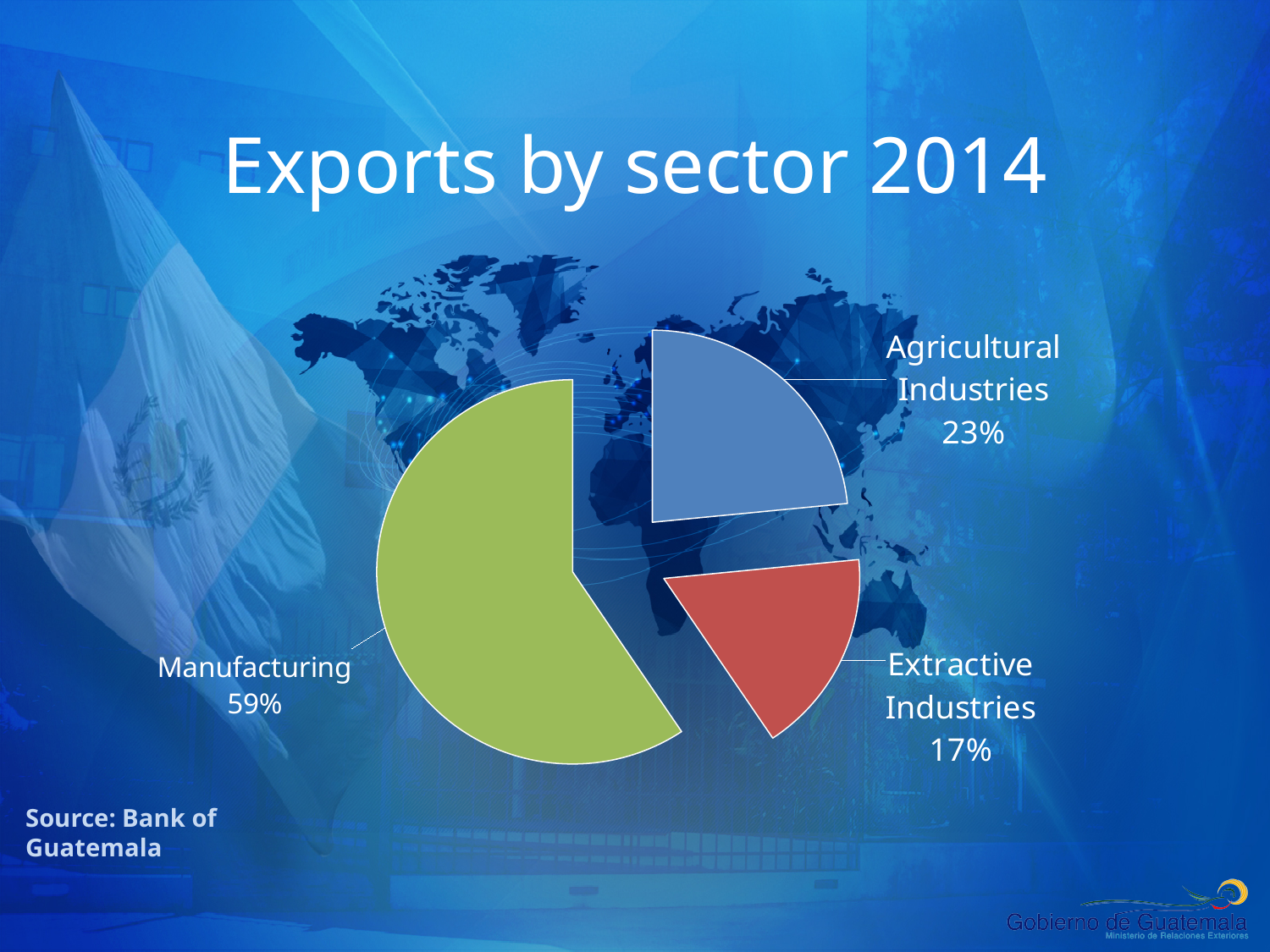
What colour is the Manufacturing slice? Green Which sector has the smallest share of exports? Extractive Industries What is the difference in percentage points between Agricultural Industries and Extractive Industries? 6 Which sector has the largest share of exports? Manufacturing What kind of chart is shown on the slide? Pie chart What is the title of the chart? Exports by sector 2014 Which has a larger share of exports, Agricultural Industries or Extractive Industries? Agricultural Industries What is the difference in percentage points between Manufacturing and Agricultural Industries? 36 What share of exports does Agricultural Industries account for? 23% What share of exports does Manufacturing account for? 59% How many sectors are shown in the pie chart? 3 What share of exports does Extractive Industries account for? 17%